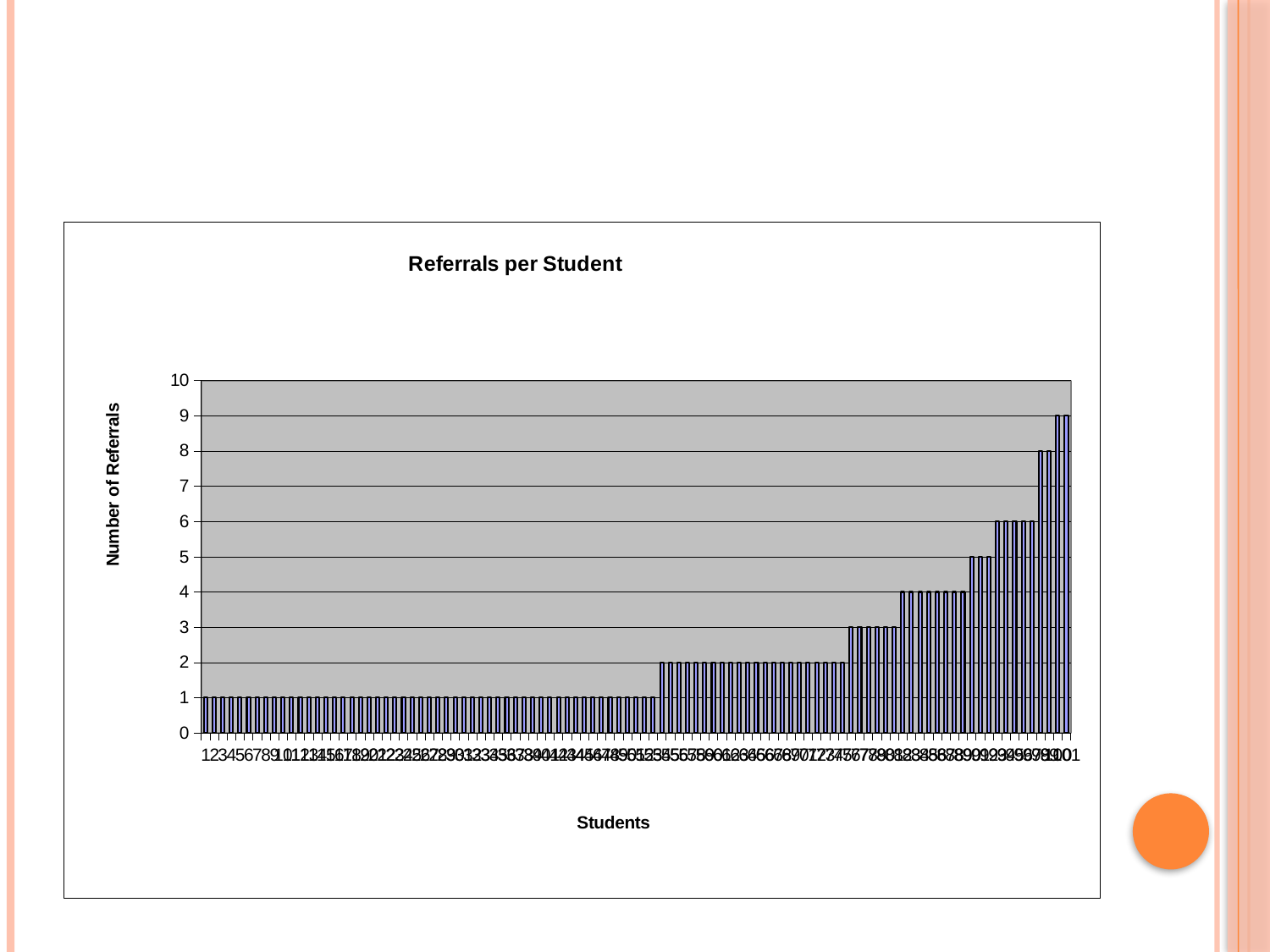
Is the value for student 1 greater or less than 5? less What is the difference in referrals between student 101 and student 1? 8 Is the value for student 101 greater or less than 5? greater What is the highest number of referrals any student has? 9 Do the values rise or fall moving from left to right along the x axis? rise What is the lowest number of referrals any student has? 1 What is the label of the vertical axis? Number of Referrals What is the title of the chart? Referrals per Student What kind of chart is shown on the slide? bar chart How many referrals does student 101 have? 9 How many referrals does student 1 have? 1 Which has more referrals, student 1 or student 101? student 101